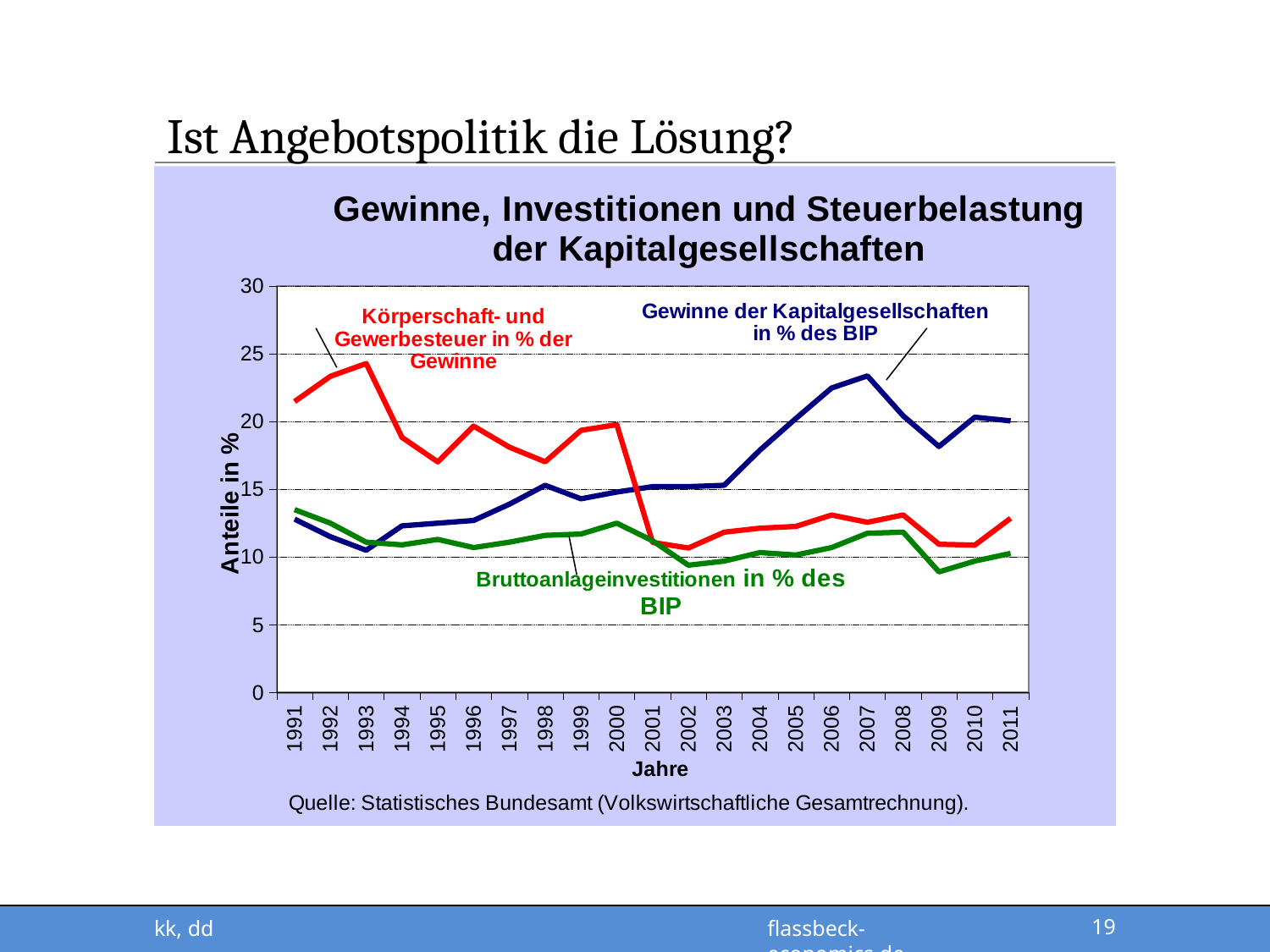
Does the Gewinne der Kapitalgesellschaften in % des BIP series rise or fall between 2003 and 2007? rise How many data series are plotted in the chart? 3 Is the value for Körperschaft- und Gewerbesteuer in % der Gewinne in 2002 greater or less than 15? less What is the label of the y axis? Anteile in % In 1991, which is larger: Körperschaft- und Gewerbesteuer in % der Gewinne or Gewinne der Kapitalgesellschaften in % des BIP? Körperschaft- und Gewerbesteuer in % der Gewinne What is the title of the chart? Gewinne, Investitionen und Steuerbelastung der Kapitalgesellschaften What kind of chart is shown on the slide? Line chart How many years are plotted along the x axis? 21 Is the value for Körperschaft- und Gewerbesteuer in % der Gewinne in 1993 greater or less than 20? greater In which year does the Gewinne der Kapitalgesellschaften in % des BIP series reach its highest value? 2007 Is the value for Bruttoanlageinvestitionen in % des BIP in 2009 greater or less than 10? less